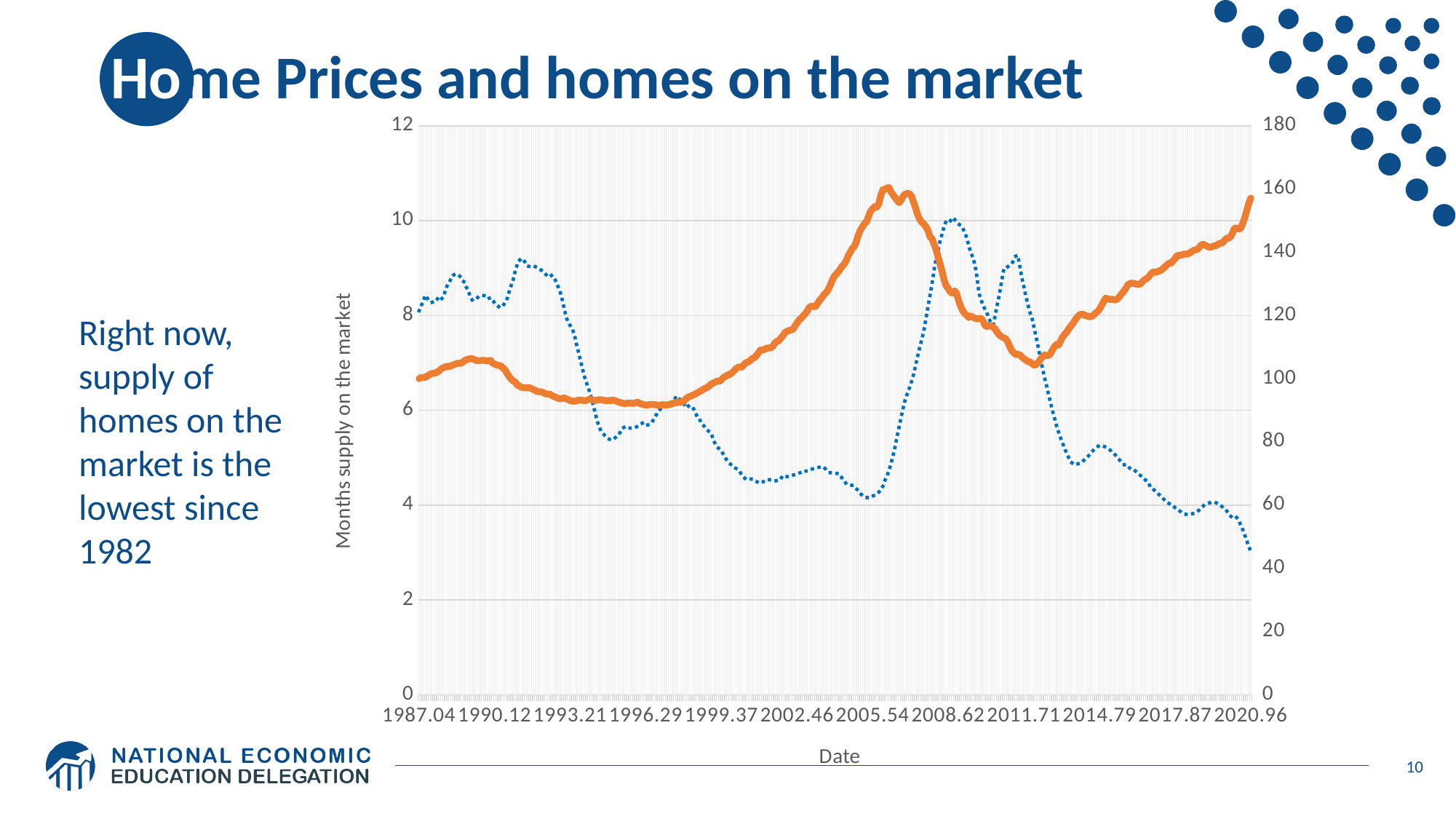
What is the label on the left vertical axis of the chart? Months supply on the market Is the value of the orange line at 2020.96 greater or less than 140 on the right axis? greater Does the orange line rise or fall between 2011.71 and 2020.96? rise Does the blue dotted line rise or fall between 2014.79 and 2020.96? fall What kind of chart is shown on the slide? line chart Is the value of the orange line at 1987.04 greater or less than 80 on the right axis? greater What is the highest tick value shown on the right vertical axis? 180 Is the value of the blue dotted line at 2020.96 greater or less than 4 on the left axis? less How many lines are plotted on the chart? 2 What is the title of the chart on the slide? Home Prices and homes on the market